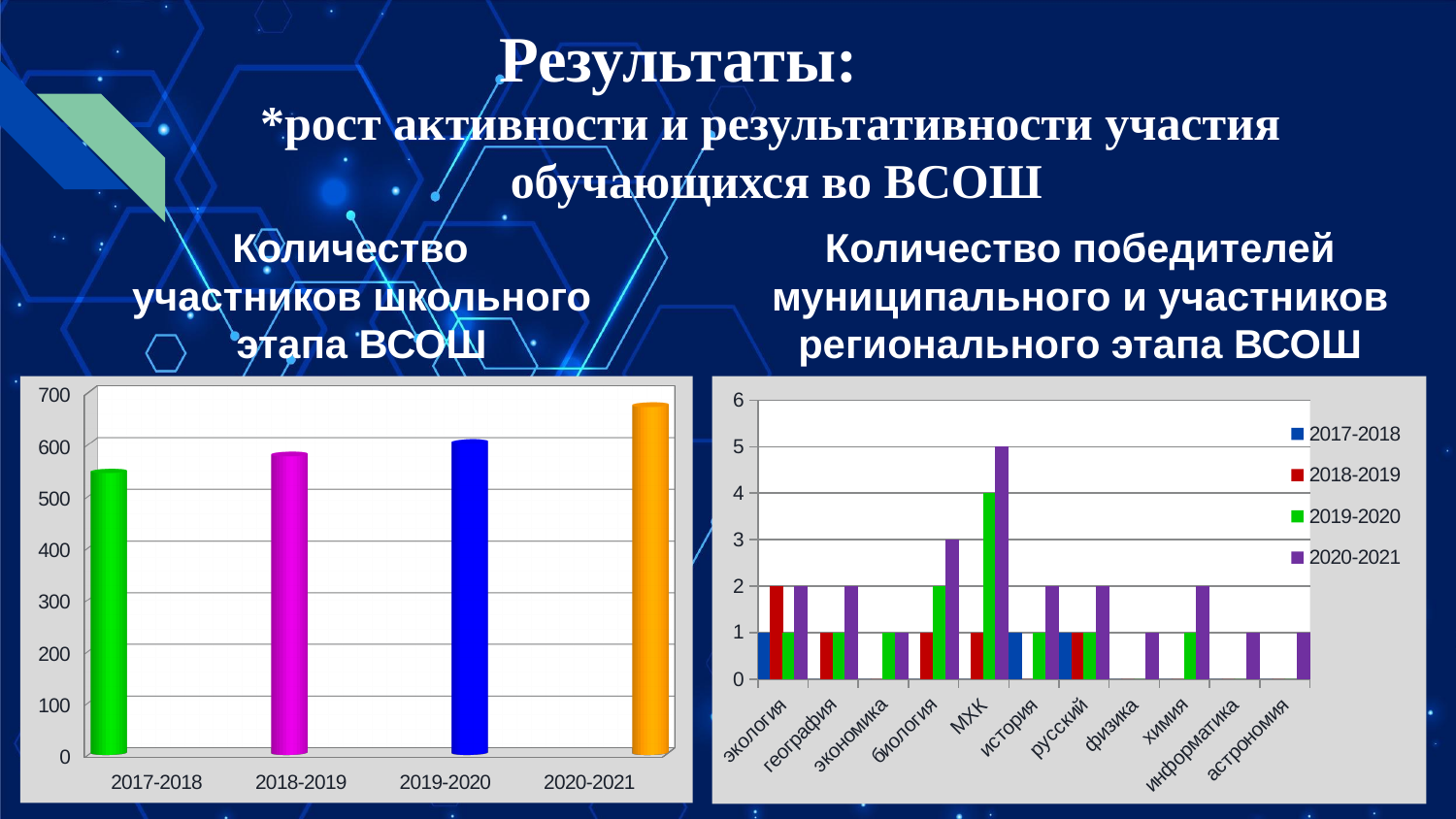
In the right chart, 'Количество победителей муниципального и участников регионального этапа ВСОШ', what is the value for биология in 2020-2021? 3 In the right chart, 'Количество победителей муниципального и участников регионального этапа ВСОШ', what is the difference between the МХК values for 2020-2021 and 2019-2020? 1 In the left chart, 'Количество участников школьного этапа ВСОШ', which year has the highest value? 2020-2021 In the left chart, 'Количество участников школьного этапа ВСОШ', do the values rise or fall from 2017-2018 to 2020-2021? rise What kind of chart is the left chart, 'Количество участников школьного этапа ВСОШ'? bar chart How many categories are shown on the x axis of the left chart, 'Количество участников школьного этапа ВСОШ'? 4 In the left chart, 'Количество участников школьного этапа ВСОШ', is the value for 2020-2021 greater or less than 600? greater In the left chart, 'Количество участников школьного этапа ВСОШ', is the value for 2017-2018 greater or less than 600? less In the left chart, 'Количество участников школьного этапа ВСОШ', which year has the lowest value? 2017-2018 How many series does the legend of the right chart, 'Количество победителей муниципального и участников регионального этапа ВСОШ', list? 4 In the right chart, 'Количество победителей муниципального и участников регионального этапа ВСОШ', what is the value for МХК in 2020-2021? 5 How many subject categories are shown on the x axis of the right chart, 'Количество победителей муниципального и участников регионального этапа ВСОШ'? 11